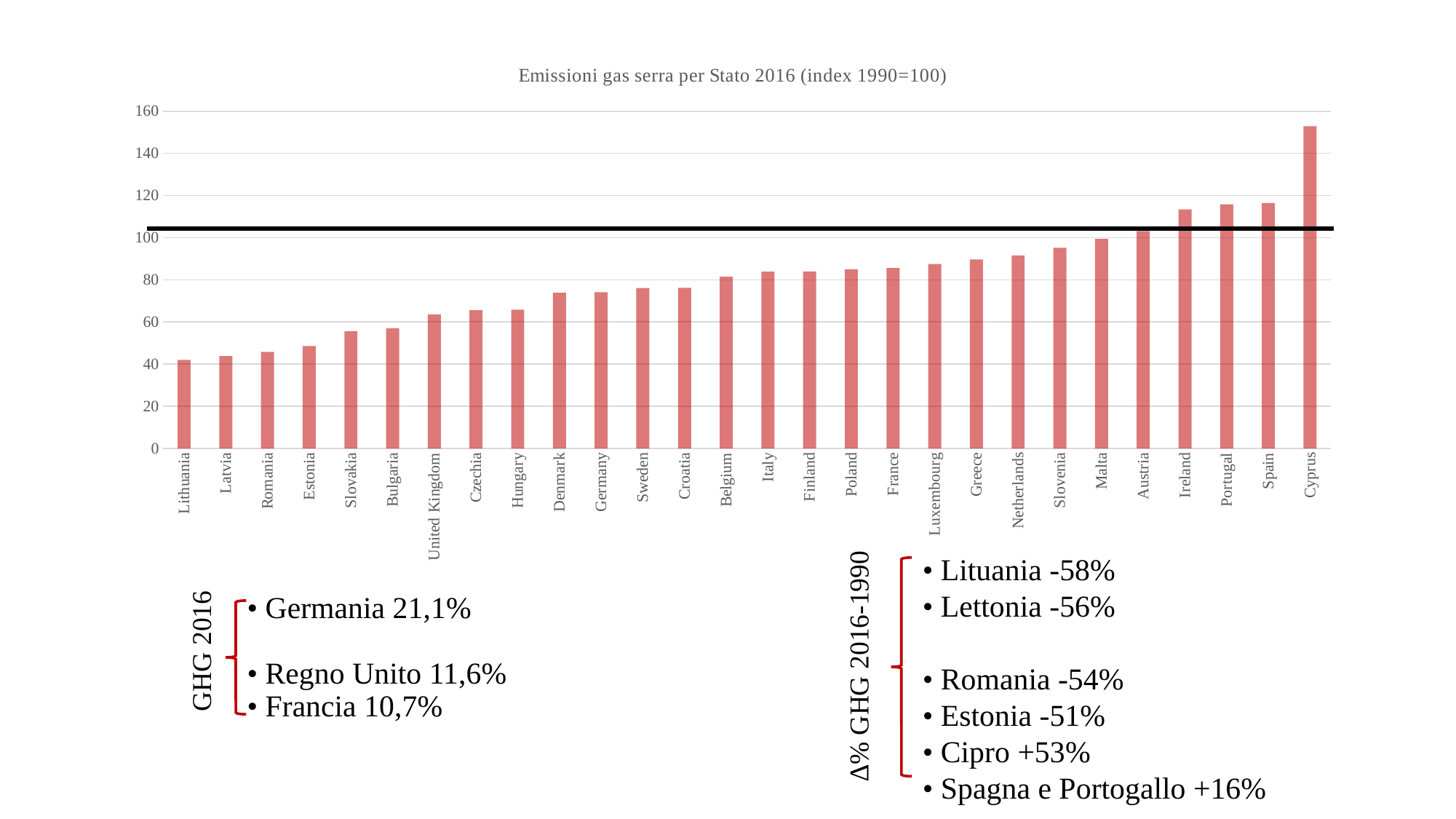
Is the value for Germany greater or less than 80? less Which has a larger value, Cyprus or Spain? Cyprus How many countries are plotted on the chart? 28 What is the title of the chart? Emissioni gas serra per Stato 2016 (index 1990=100) Which has a larger value, Lithuania or Germany? Germany Is the value for Ireland greater or less than 100? greater Do the values rise or fall from left to right along the x axis? rise What kind of chart is shown on the slide? bar chart Which country has the highest value on the chart? Cyprus Is the value for Cyprus greater or less than 140? greater